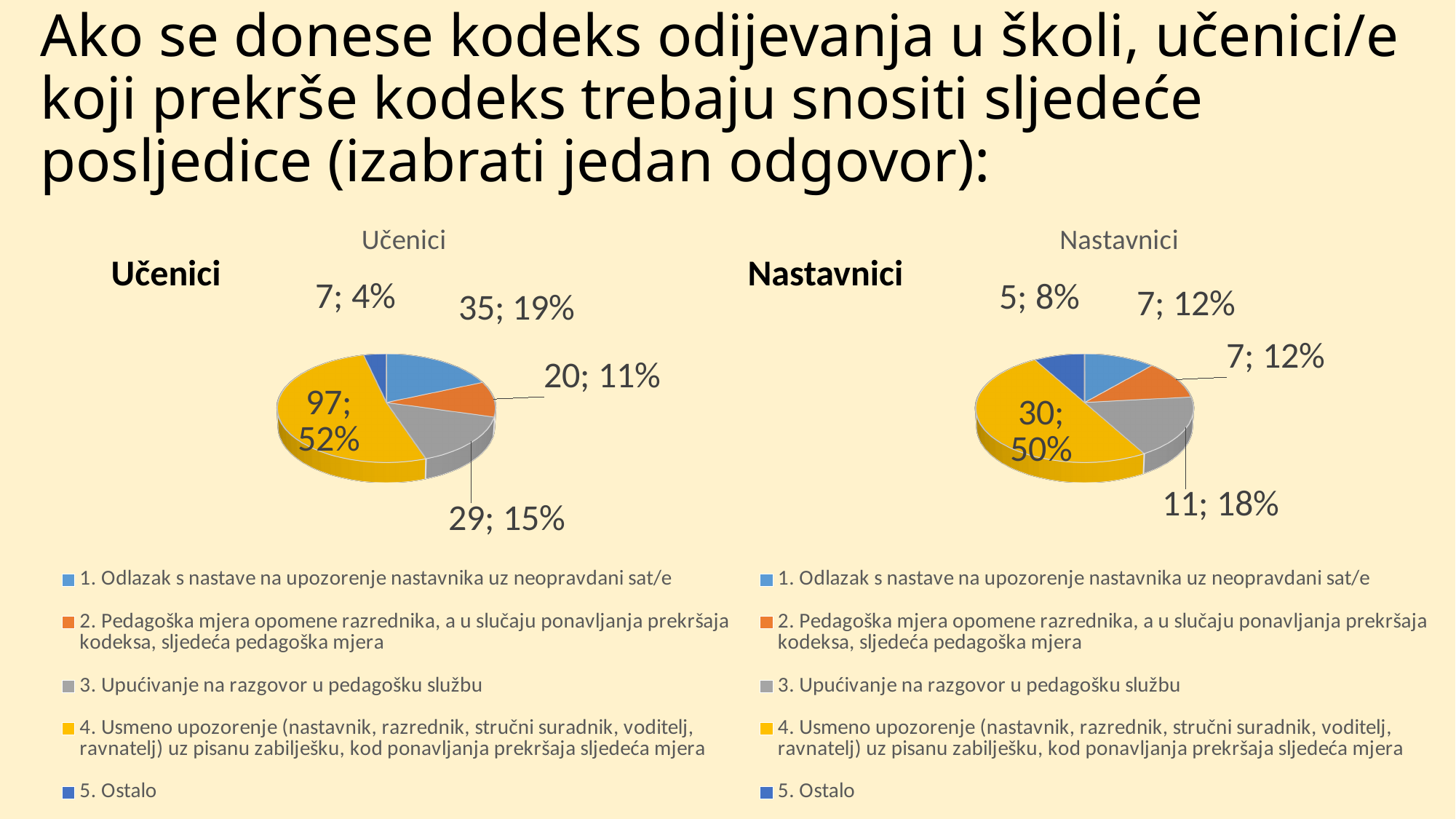
In the Nastavnici chart, which option has the largest slice? 4. Usmeno upozorenje (nastavnik, razrednik, stručni suradnik, voditelj, ravnatelj) uz pisanu zabilješku, kod ponavljanja prekršaja sljedeća mjera How many slices does the Nastavnici pie chart have? 5 In the Učenici chart, what value is shown for option 4 (Usmeno upozorenje ... uz pisanu zabilješku)? 97; 52% In the Učenici chart, which option has the smallest slice? 5. Ostalo In the Učenici chart, which is larger: the slice for option 1 or the slice for option 2? Option 1 What colour is the slice for option 4 in both pie charts? Yellow In the Nastavnici chart, what is the difference in count between option 4 (30) and option 3 (11)? 19 In the Nastavnici chart, what share of the pie does option 5 (Ostalo) take? 8% In the Nastavnici chart, what value is shown for option 3 (Upućivanje na razgovor u pedagošku službu)? 11; 18% In the Učenici chart, what is the difference in count between option 1 (35) and option 3 (29)? 6 What type of chart is used for the Učenici data? Pie chart In the Učenici chart, what value is shown for option 5 (Ostalo)? 7; 4%